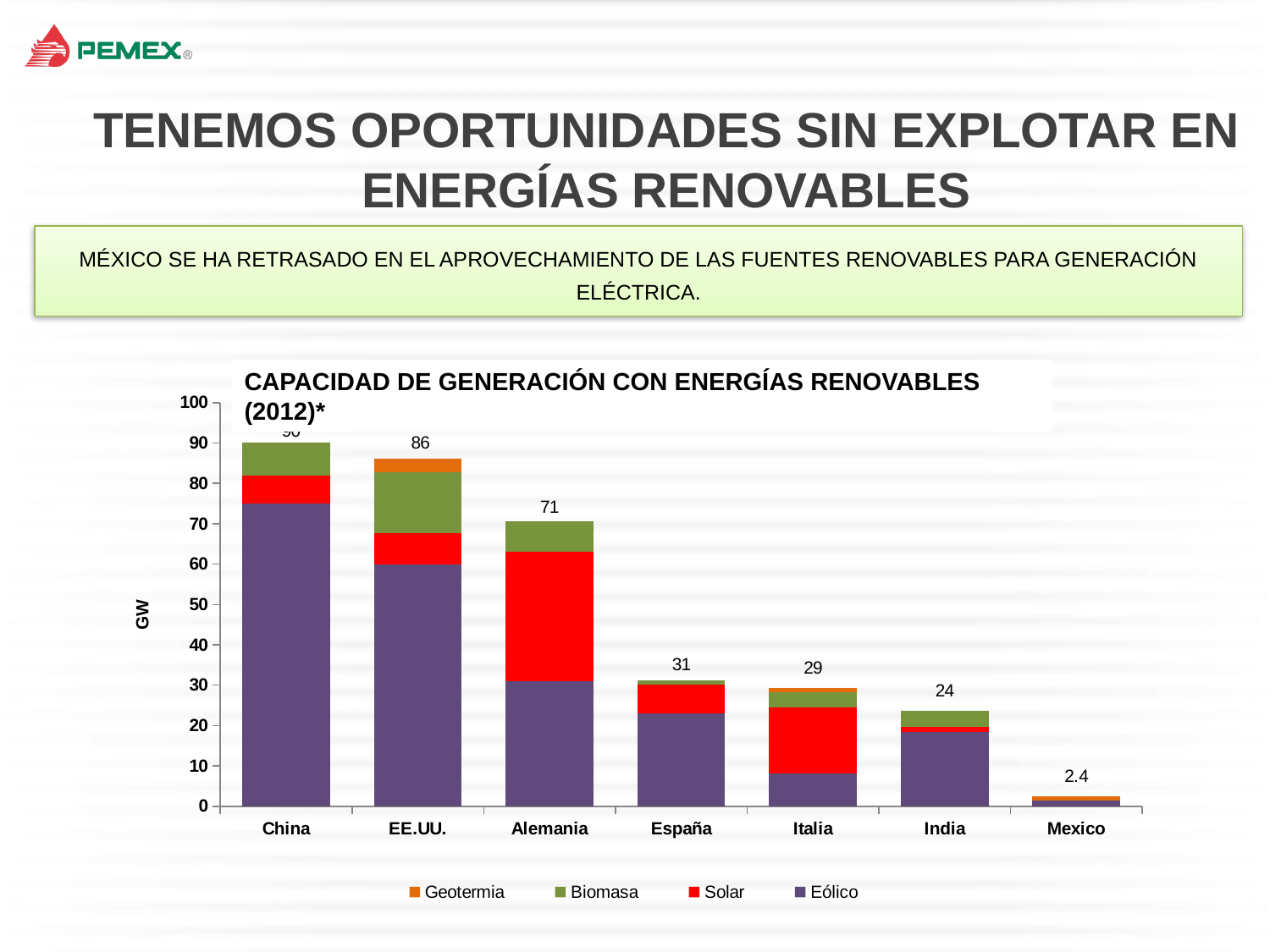
Is the Eólico value for Italia greater or less than 10? less Which has a larger total, Alemania or España? Alemania Is the Eólico value for China greater or less than 70? greater What kind of chart is shown? Stacked bar chart What is the total value shown for Alemania? 71 What is the difference between the totals for EE.UU. and Alemania? 15 What is the total value shown for Mexico? 2.4 What is the difference between the totals for Italia and India? 5 Which country has the lowest total renewable generation capacity? Mexico How many series does the legend list? 4 What is the total renewable generation capacity shown for EE.UU.? 86 How many countries are shown on the x axis? 7